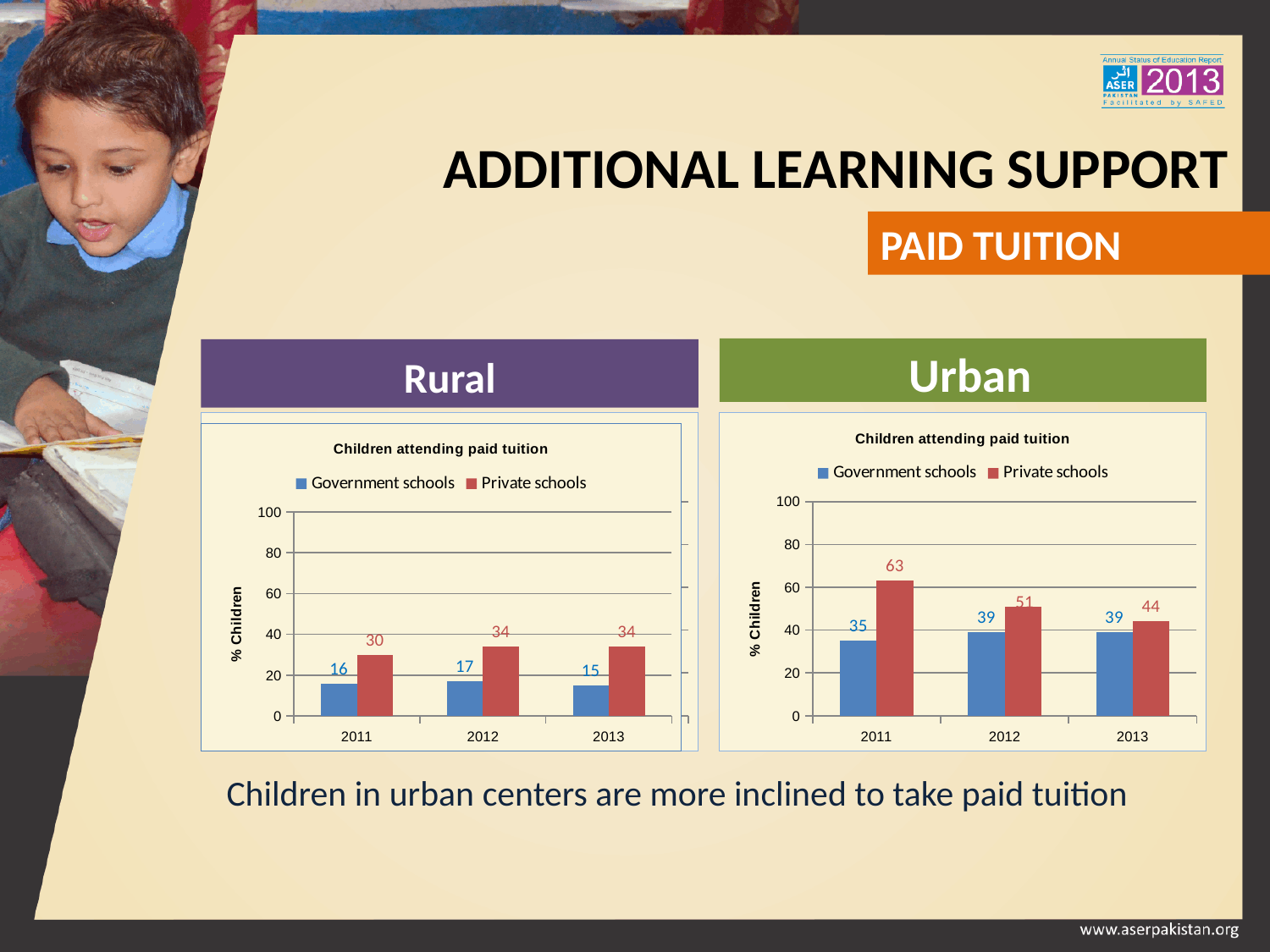
How many series does the legend of the Urban chart list? 2 What kind of chart is the Rural chart? Bar chart In the Urban chart, which is larger in 2013: Government schools or Private schools? Private schools In the Urban chart, what is the value for Government schools in 2011? 35 How many years are shown on the x axis of the Rural chart? 3 In the Rural chart, which year has the lowest value for Government schools? 2013 In the Rural chart, what is the difference between Private schools and Government schools in 2013? 19 In the Urban chart, which year has the highest value for Private schools? 2011 In the Urban chart, do the Private schools values rise or fall from 2011 to 2013? Fall In the Urban chart, is the value for Private schools in 2011 greater or less than 60? greater In the Urban chart, what is the difference between Private schools and Government schools in 2011? 28 In the Rural chart, what is the value for Private schools in 2012? 34